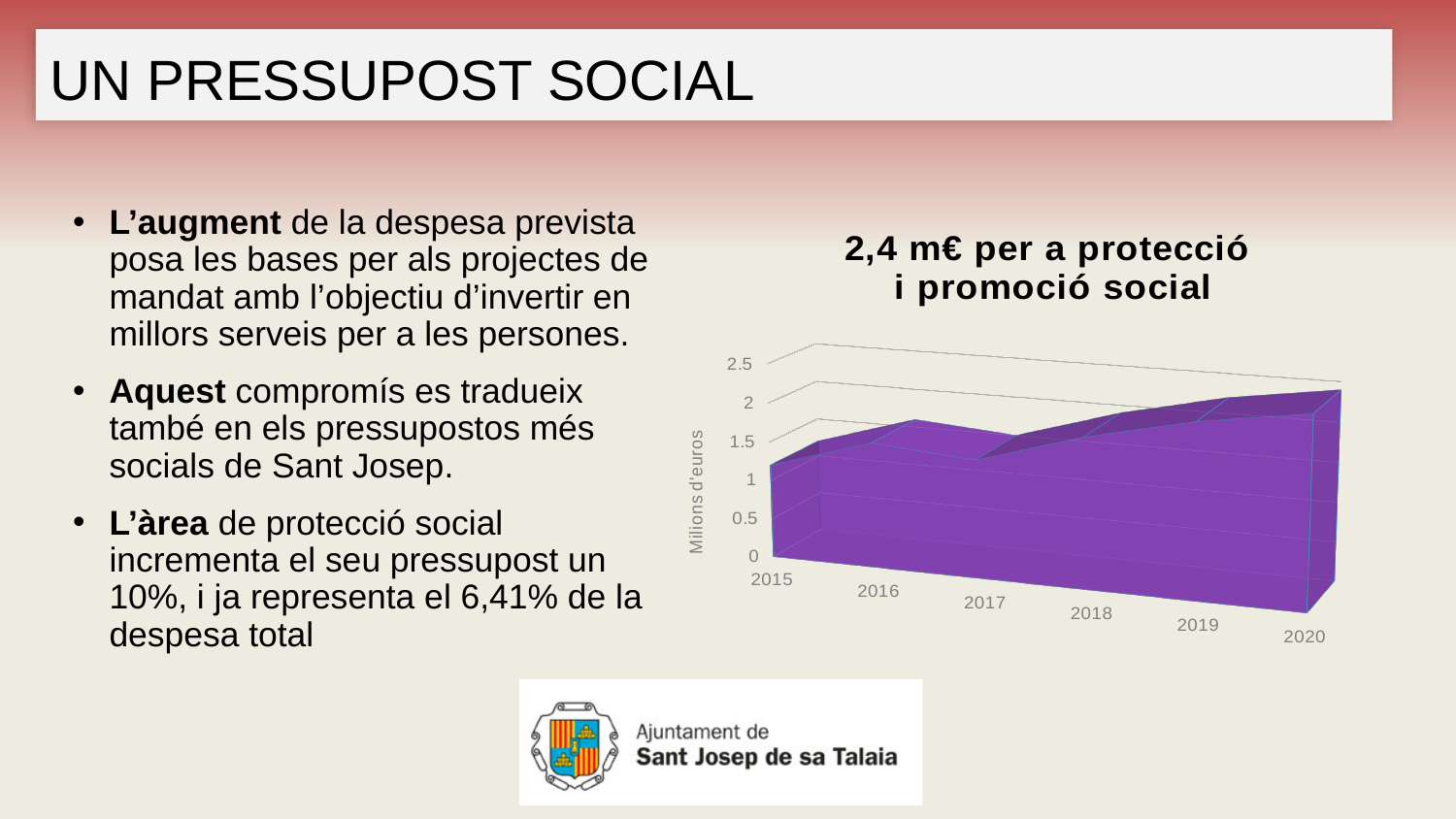
Which is larger, the value for 2020 or the value for 2015? 2020 How many years are shown on the x axis of the chart? 6 Which year has the highest value in the chart? 2020 Which year has the lowest value in the chart? 2015 Which is larger, the value for 2019 or the value for 2015? 2019 Overall, do the values rise or fall from 2015 to 2020? rise What is the first year shown on the x axis? 2015 Is the value for 2015 greater or less than 2? less What kind of chart is shown on the slide? area chart Is the value for 2020 greater or less than 1? greater What is the title of the chart? 2,4 m€ per a protecció i promoció social What is the label on the vertical axis of the chart? Milions d'euros